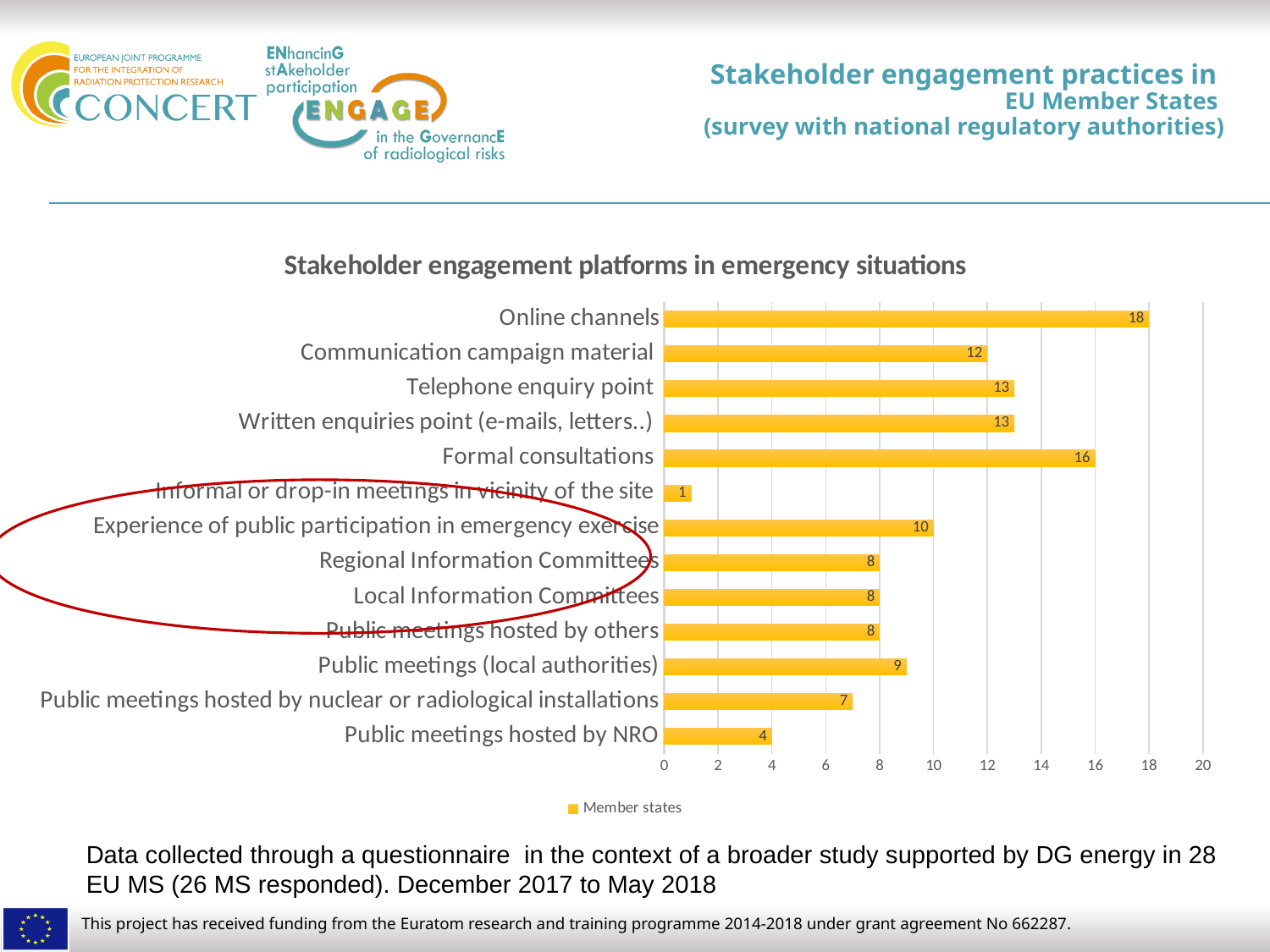
Which category has the highest value? Online channels How many series does the legend list? 1 How many categories are shown in the chart? 13 Which is larger, the value for Communication campaign material or the value for Telephone enquiry point? Telephone enquiry point What kind of chart is shown? Bar chart What is the difference between the values for Online channels and Formal consultations? 2 What is the title of the chart? Stakeholder engagement platforms in emergency situations Which category has the lowest value? Informal or drop-in meetings in vicinity of the site What is the value for Experience of public participation in emergency exercise? 10 What is the value for Formal consultations? 16 What is the value for Public meetings hosted by NRO? 4 What is the value for Online channels? 18